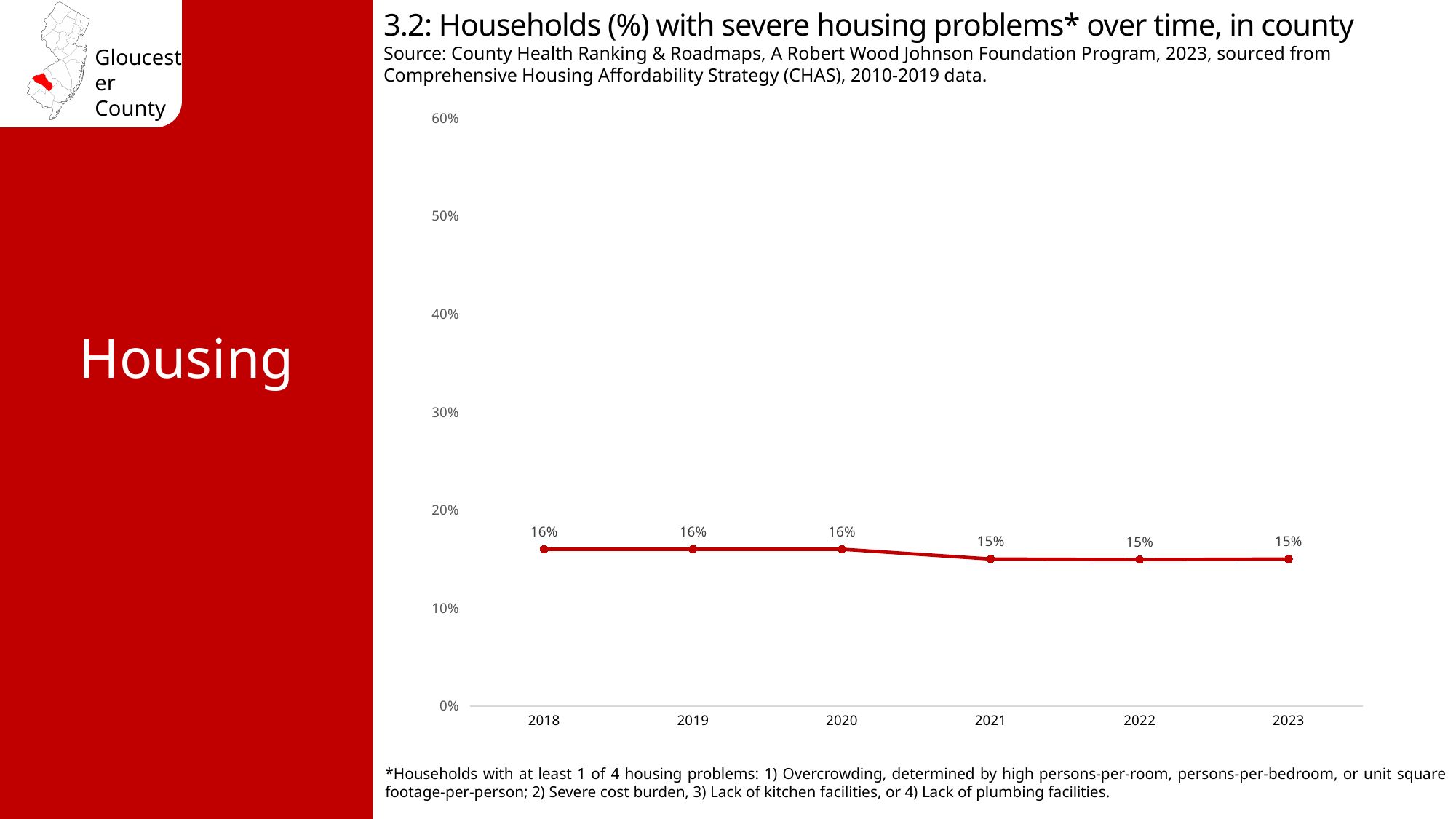
What is the value shown for 2020? 16% Do the values rise, fall, or stay roughly flat from 2018 to 2023? fall slightly What kind of chart is shown on the slide? line chart Which is larger, the value for 2020 or the value for 2021? 2020 How many years are plotted on the chart? 6 Is the value for 2022 greater or less than 10%? greater What is the value shown for 2023? 15% What is the difference between the 2018 value and the 2023 value? 1% What percentage of households had severe housing problems in 2018? 16% Is the value for 2019 greater or less than 20%? less What is the title of the chart? 3.2: Households (%) with severe housing problems* over time, in county What percentage of households had severe housing problems in 2021? 15%